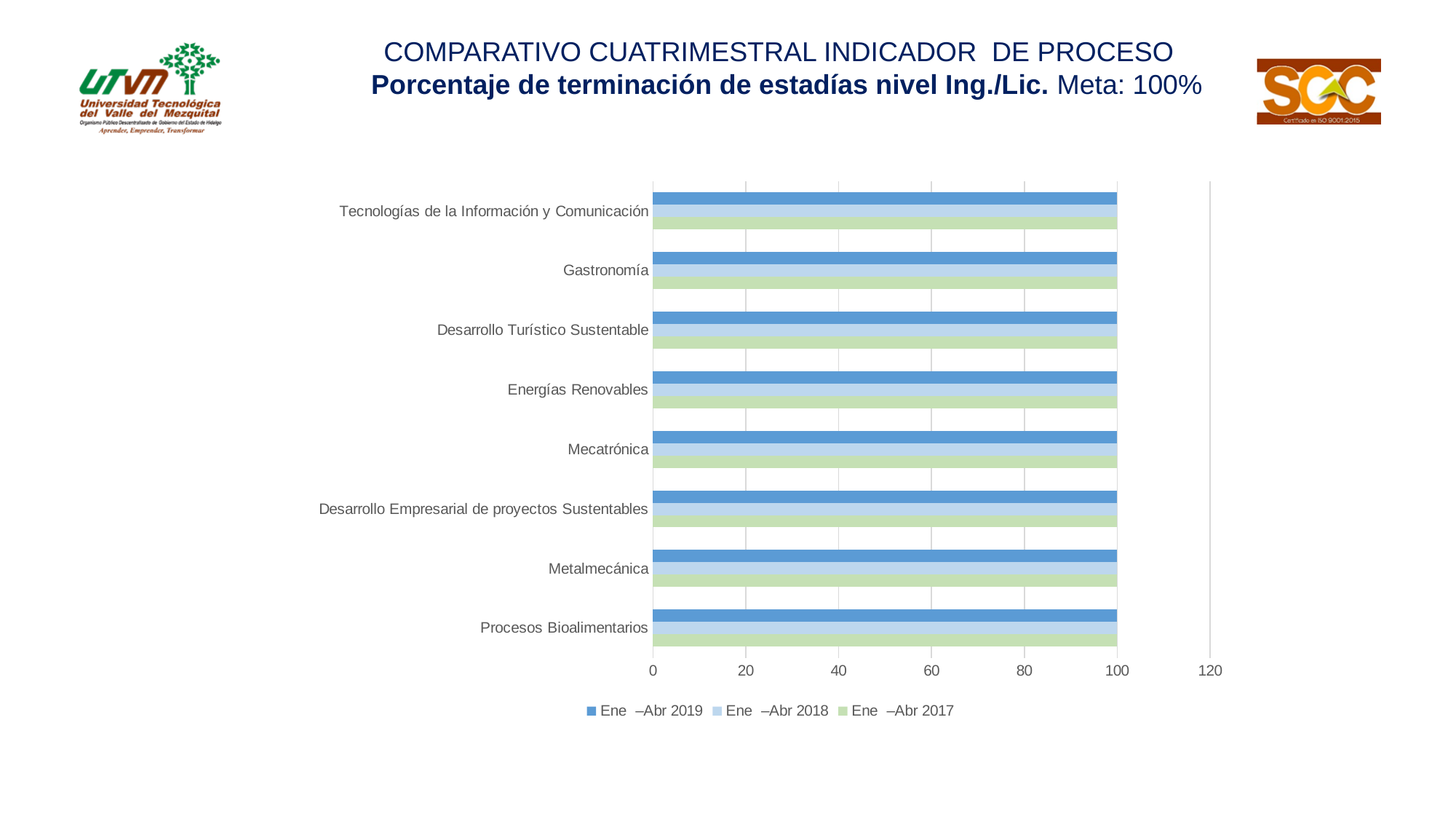
Is the value for Energías Renovables in the Ene –Abr 2017 series greater or less than 120? less Which series is shown in the darkest blue colour in the legend? Ene –Abr 2019 Is the value for Metalmecánica in the Ene –Abr 2019 series greater or less than 80? greater How many series does the legend list? 3 What is the value for Procesos Bioalimentarios in the Ene –Abr 2018 series? 100 What is the difference between the Ene –Abr 2019 and Ene –Abr 2018 values for Desarrollo Turístico Sustentable? 0 What kind of chart is shown on the slide? bar chart What is the target (Meta) stated in the slide title? 100% What is the value for Mecatrónica in the Ene –Abr 2019 series? 100 What is the value for Gastronomía in the Ene –Abr 2017 series? 100 How many categories (programs) are listed on the chart? 8 What is the highest value shown on the x axis? 120